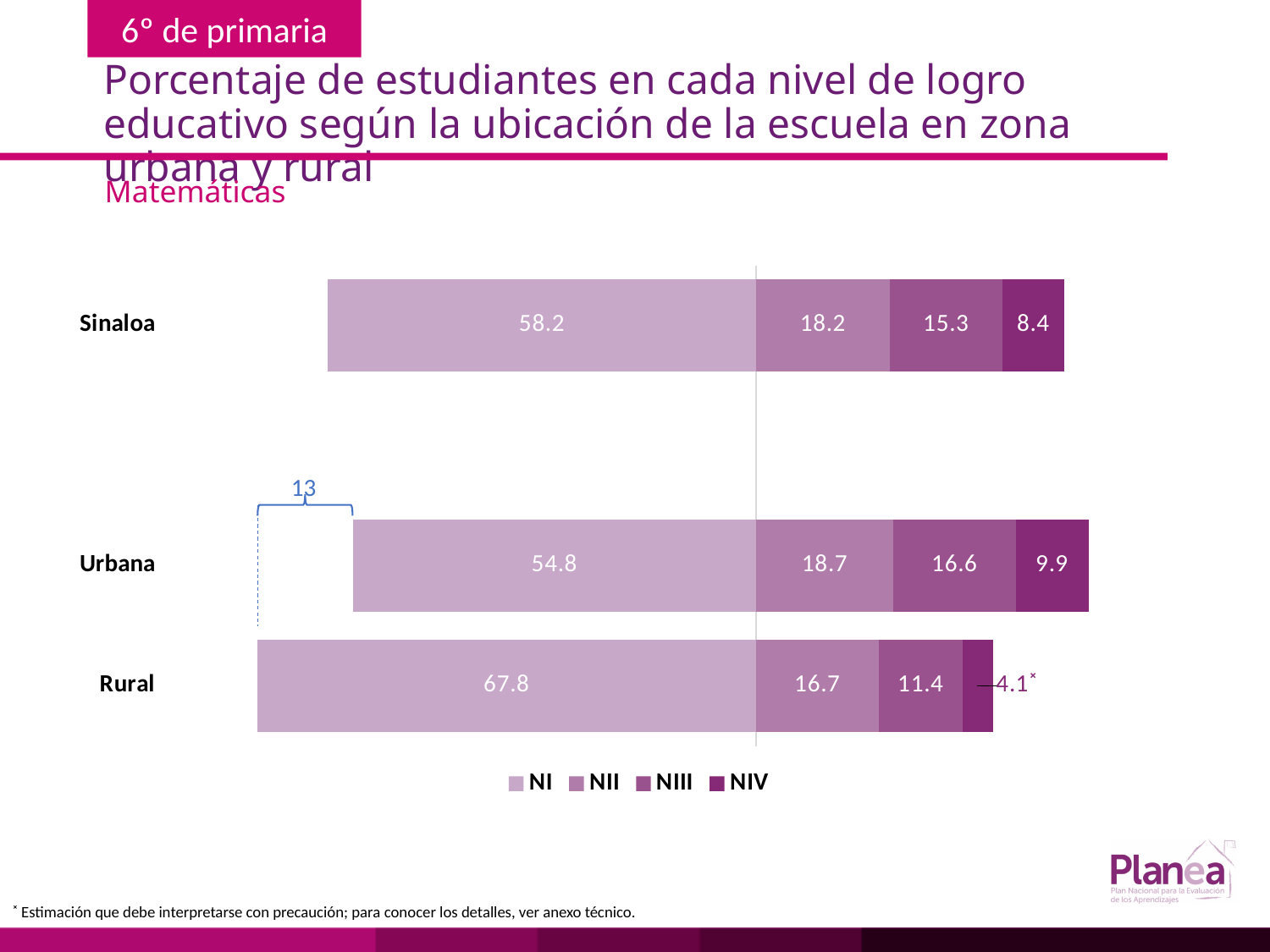
What type of chart is shown on the slide? stacked bar chart What is the NIV value for Urbana? 9.9 How many series does the legend list? 4 Which series is listed first in the legend? NI What is the NII value for Rural? 16.7 What is the total of the stacked bar for Urbana? 100.0 How many categories are plotted on the chart? 3 What is the difference between the NI values for Rural and Urbana? 13 What is the NI value for Sinaloa? 58.2 Which category has the highest NI value? Rural Which is larger, the NIII value for Urbana or the NIII value for Sinaloa? Urbana Which category has the lowest NIV value? Rural